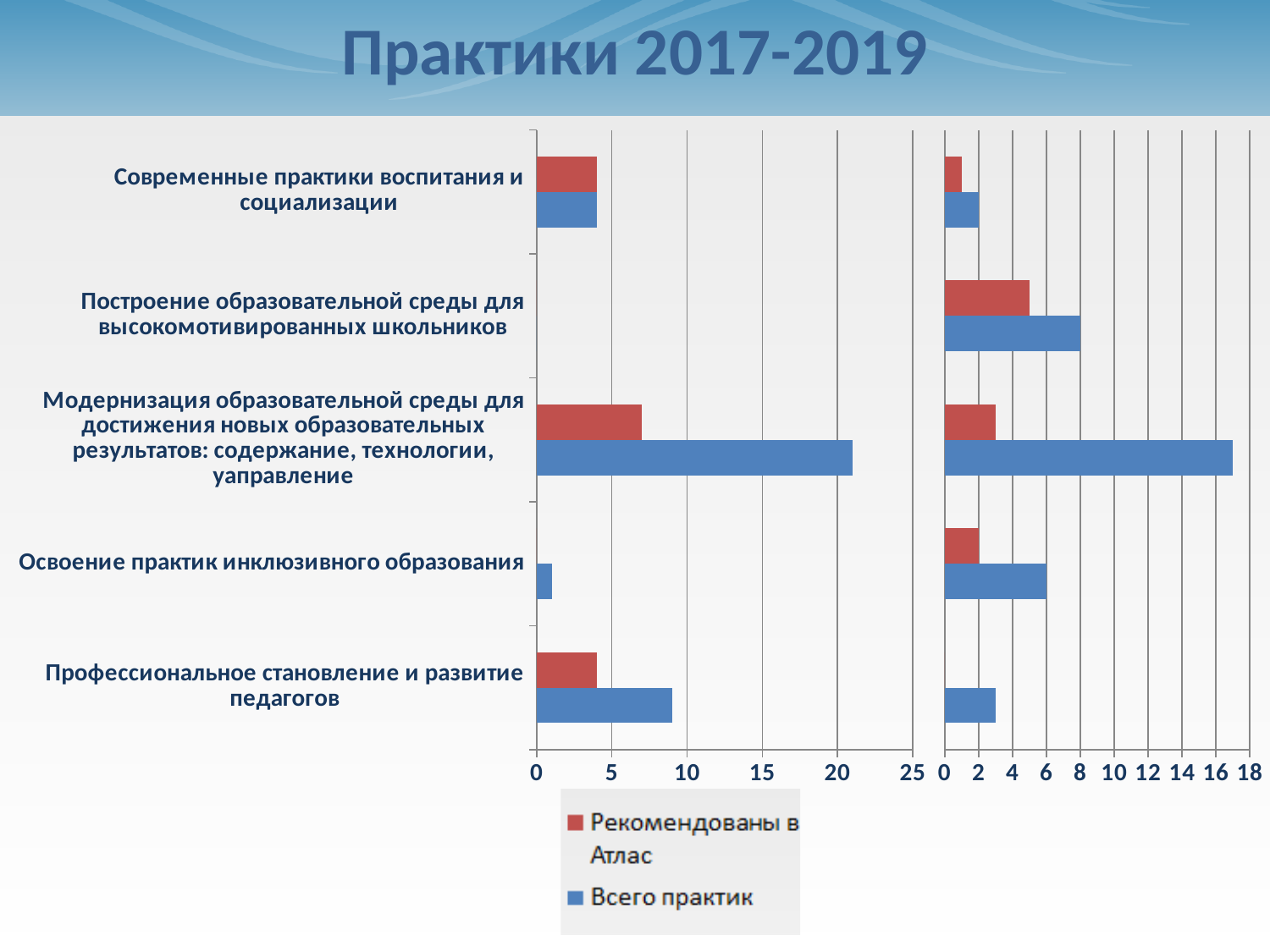
On the right chart, is the value of Всего практик for Модернизация образовательной среды greater or less than 16? greater On the left chart, which has the larger value for Рекомендованы в Атлас: Модернизация образовательной среды or Профессиональное становление и развитие педагогов? Модернизация образовательной среды On the left chart, which category has the highest value for Всего практик? Модернизация образовательной среды для достижения новых образовательных результатов: содержание, технологии, управление On the right chart, which category has the highest value for Всего практик? Модернизация образовательной среды для достижения новых образовательных результатов: содержание, технологии, управление How many series does the legend list? 2 On the left chart, is the value of Всего практик for Модернизация образовательной среды greater or less than 20? greater How many categories are shown on the left chart? 5 What colour represents the series Всего практик in the legend? blue On the right chart, which has the larger value for Всего практик: Построение образовательной среды для высокомотивированных школьников or Освоение практик инклюзивного образования? Построение образовательной среды для высокомотивированных школьников What kind of chart is the left chart on the slide? bar chart On the right chart, which category has the highest value for Рекомендованы в Атлас? Построение образовательной среды для высокомотивированных школьников On the left chart, is the value of Всего практик for Профессиональное становление и развитие педагогов greater or less than 10? less